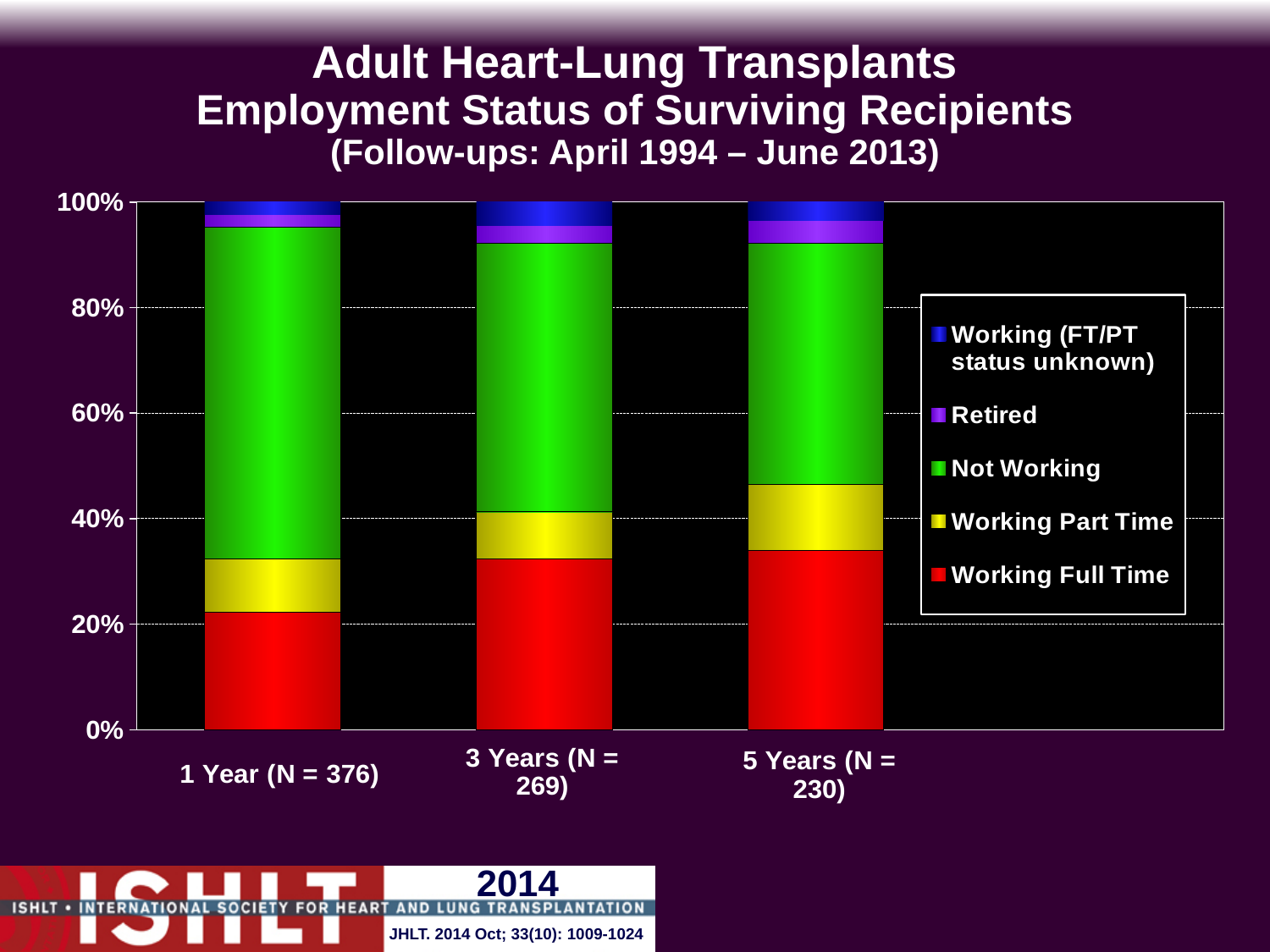
What kind of chart is shown on the slide? Stacked bar chart How many follow-up time categories are shown on the x axis? 3 Is the Working Full Time share at 5 Years greater or less than 20%? greater Is the Working Part Time share at 1 Year greater or less than 20%? less How many series does the legend list? 5 What does each stacked bar total? 100% Which colour represents the Retired series in the legend? Purple What is the sample size (N) for the 3 Years category? 269 Which is larger: the Working Full Time share at 1 Year or at 5 Years? 5 Years Does the Not Working share rise or fall from 1 Year to 5 Years? Fall Which follow-up category has the largest Not Working share? 1 Year (N = 376) Is the Working Full Time share at 1 Year greater or less than 40%? less